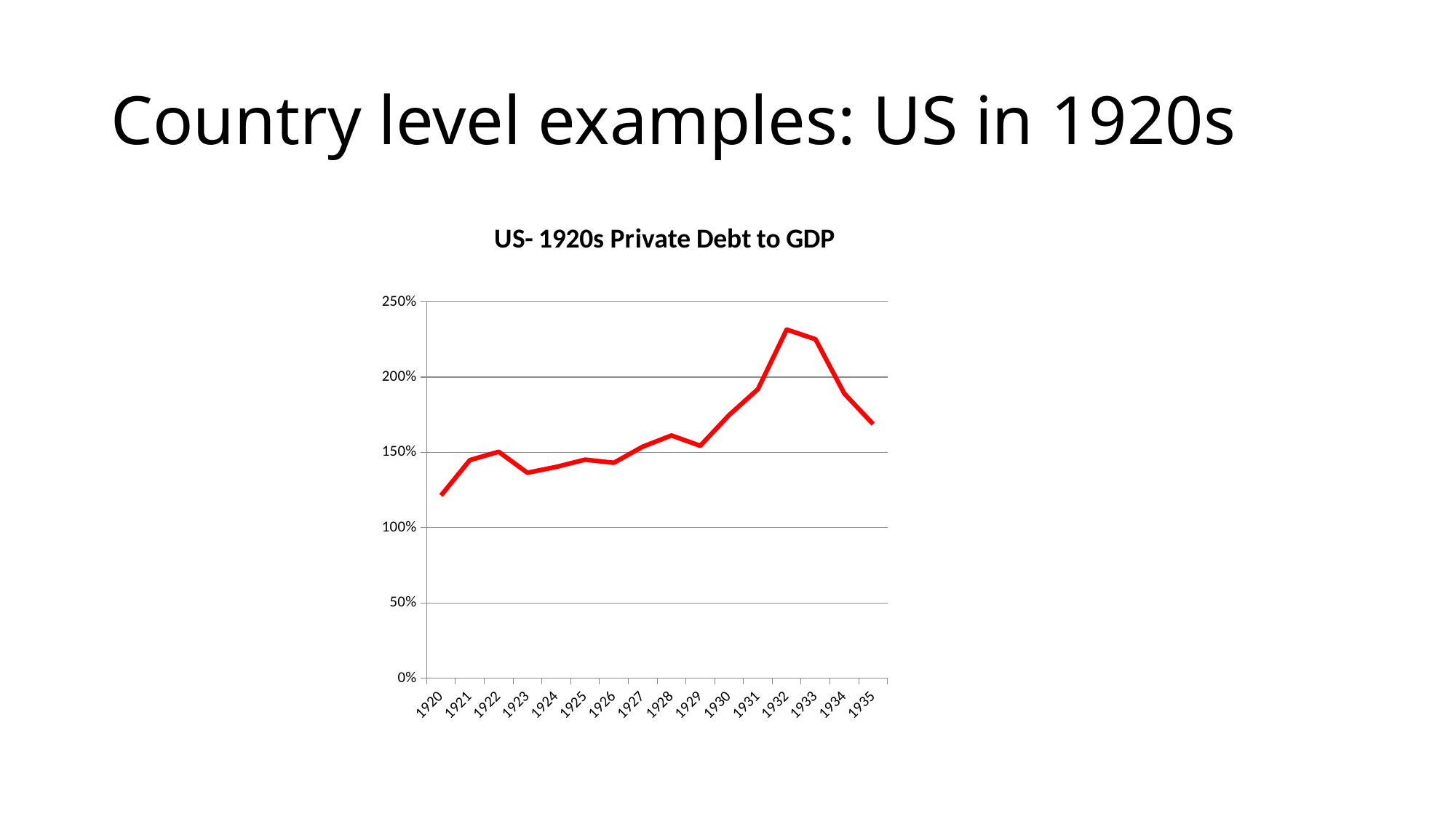
What kind of chart is shown on the slide? line chart Is the value for 1920 greater or less than 150%? less Is the value for 1931 greater or less than 200%? less In which year does private debt to GDP reach its highest value? 1932 In which year is private debt to GDP at its lowest? 1920 Which year has the higher value, 1932 or 1935? 1932 Is the value for 1932 greater or less than 200%? greater What colour is the plotted line? red Does the value rise or fall from 1932 to 1935? fall How many years are plotted along the x axis? 16 What is the title of the chart? US- 1920s Private Debt to GDP